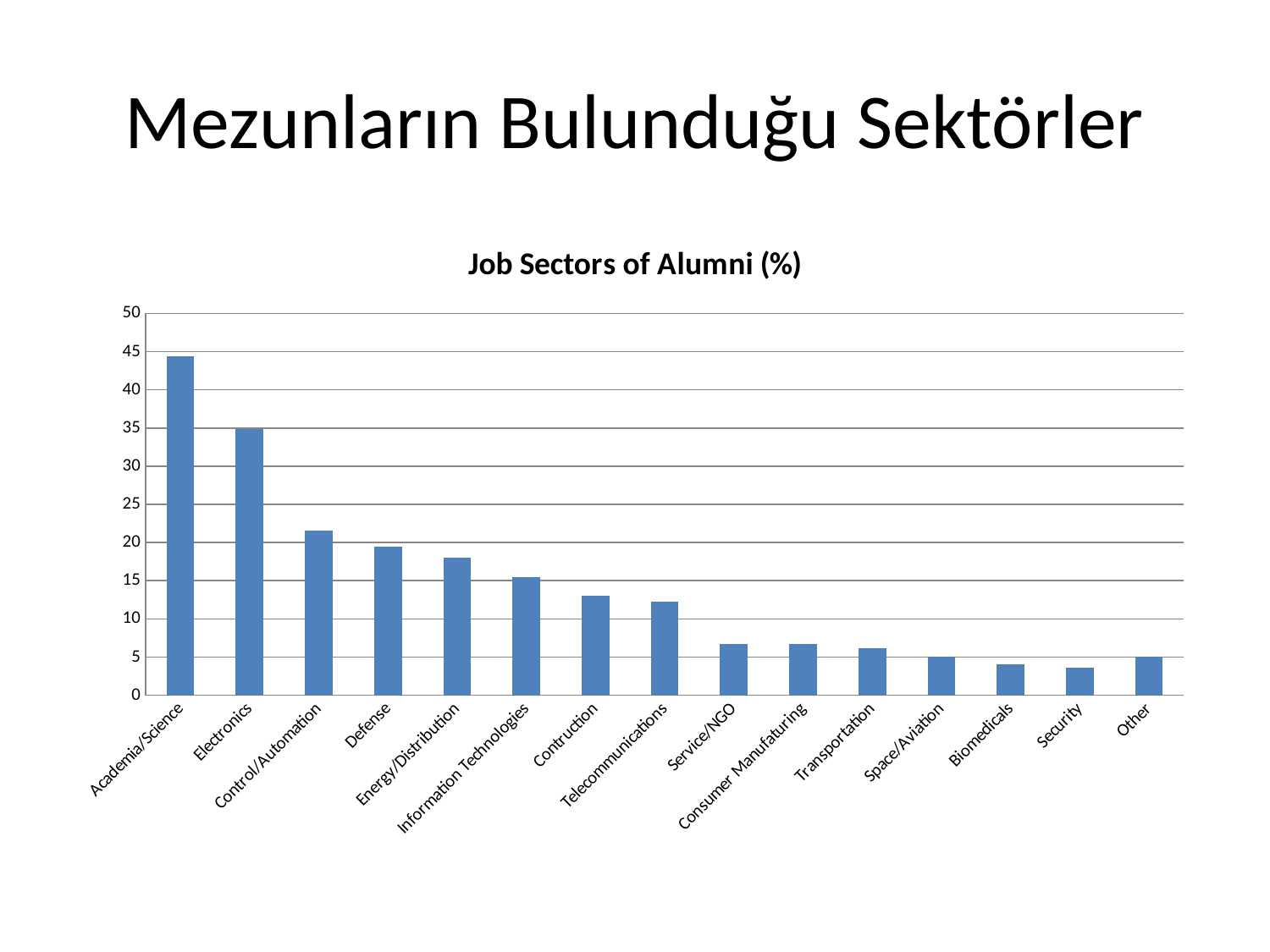
Is the value for Electronics greater or less than 30? greater What is the title of the chart? Job Sectors of Alumni (%) Is the value for Telecommunications greater or less than 10? greater Which job sector has the highest percentage of alumni? Academia/Science Do the bar values generally rise or fall from left to right across the x axis? fall Is the value for Control/Automation greater or less than 20? greater Which has a larger value, Electronics or Control/Automation? Electronics What kind of chart is shown on the slide? bar chart How many job sector categories are shown on the x axis? 15